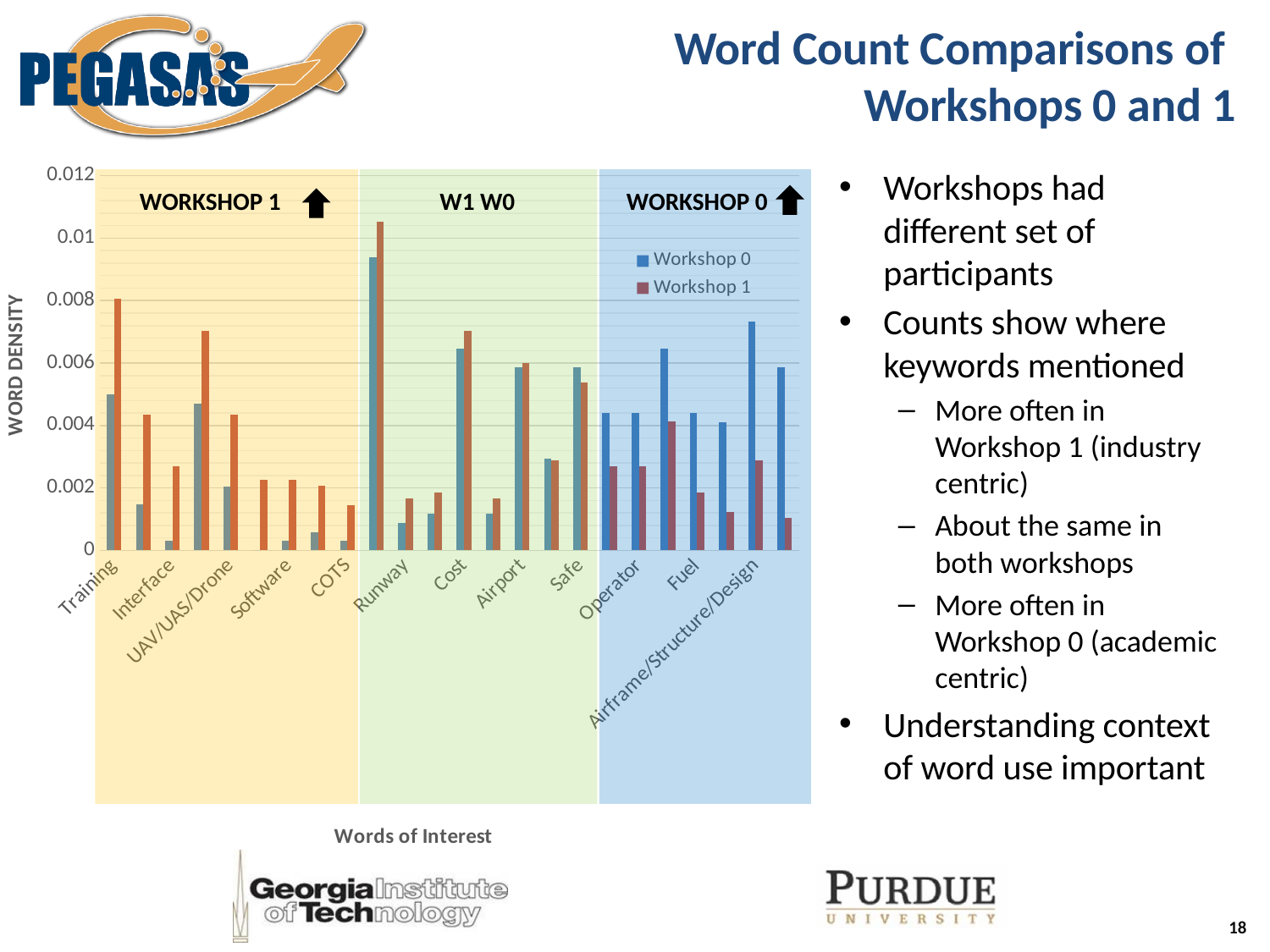
What are the two series named in the chart legend? Workshop 0 and Workshop 1 Is the tallest bar in the chart greater or less than 0.01? greater Is the Workshop 1 value for Training greater or less than 0.01? less What is the title of the vertical axis of the chart? WORD DENSITY For the category Training, which series has the larger value, Workshop 0 or Workshop 1? Workshop 1 Which series contains the tallest bar in the chart, Workshop 0 or Workshop 1? Workshop 1 What kind of chart is shown on the slide? bar chart Is the Workshop 0 value for Training greater or less than 0.006? less How many series does the chart legend list? 2 What is the highest value shown on the vertical axis of the chart? 0.012